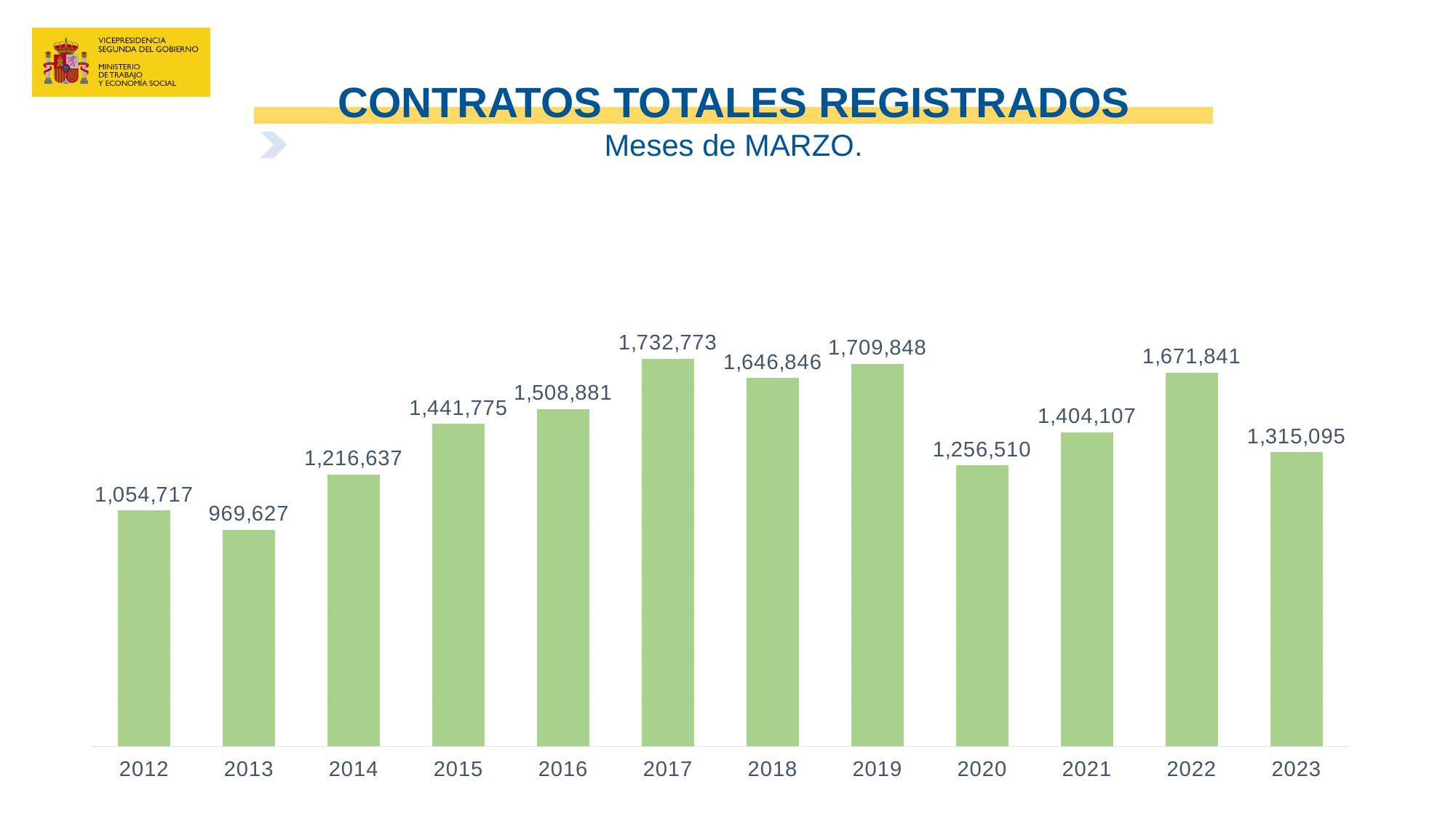
Do the values rise or fall from 2013 to 2017? Rise Which is larger, the value for 2019 or the value for 2018? 2019 What kind of chart is shown on the slide? Bar chart How many years are shown on the x axis? 12 What is the value for 2017? 1,732,773 Which year has the highest value? 2017 What is the value for 2013? 969,627 What is the difference between the values for 2022 and 2023? 356,746 What is the difference between the values for 2017 and 2013? 763,146 What is the value for 2023? 1,315,095 Which year has the lowest value? 2013 Which is larger, the value for 2020 or the value for 2021? 2021